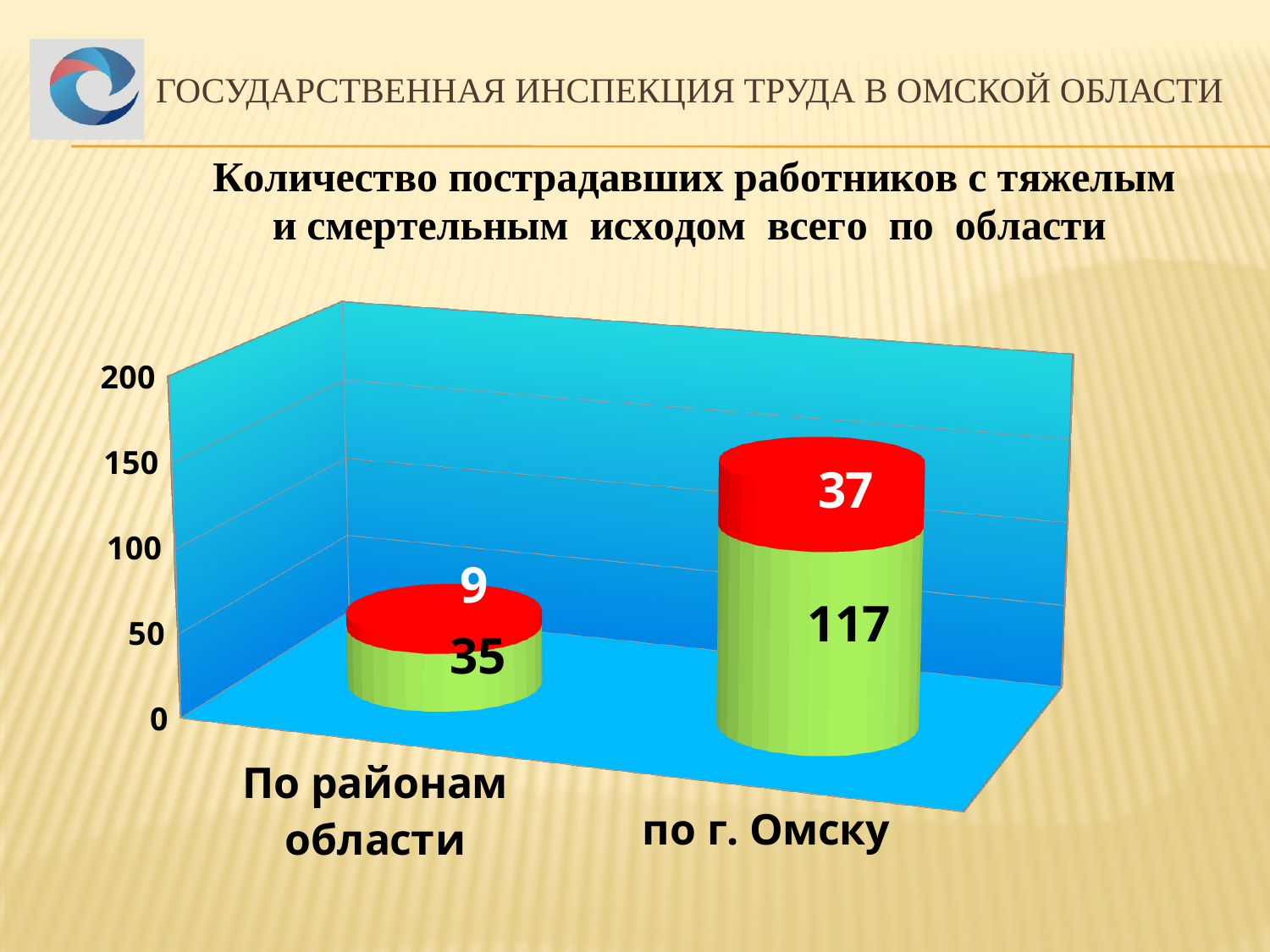
What is the total of the stacked bar for "По районам области"? 44 How many categories are shown on the x axis? 2 What is the total of the stacked bar for "по г. Омску"? 154 What is the difference between the green segment values for "по г. Омску" and "По районам области"? 82 What kind of chart is shown on the slide? Stacked bar chart Which category has the lowest total? По районам области What is the value of the green segment for "По районам области"? 35 What is the value of the red segment for "По районам области"? 9 What is the value of the red segment for "по г. Омску"? 37 What is the value of the green segment for "по г. Омску"? 117 Which category has the higher total, "По районам области" or "по г. Омску"? по г. Омску Is the total for "по г. Омску" greater or less than 100? greater